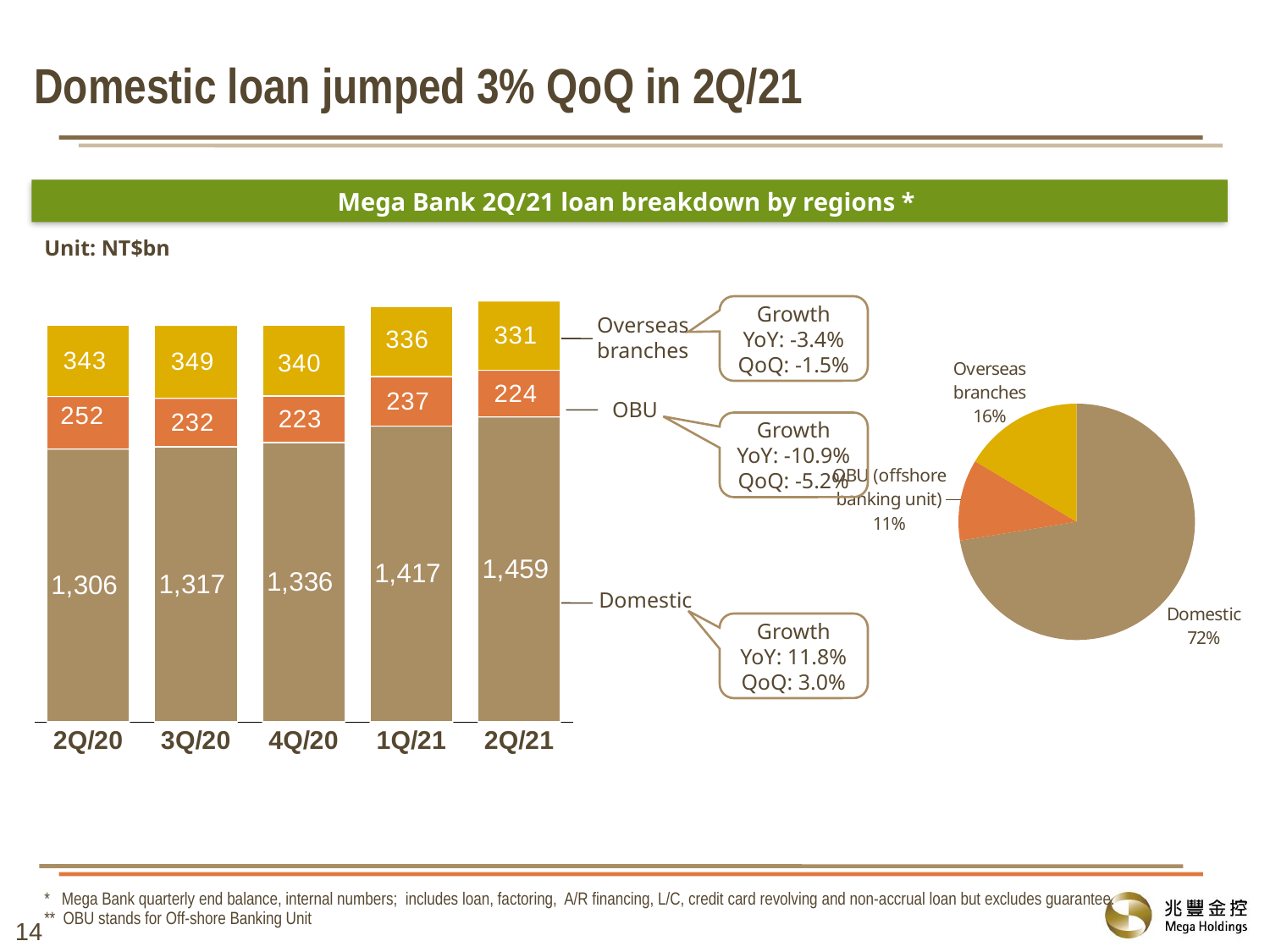
In the stacked bar chart, what is the total loan balance for 2Q/21 (sum of the three segments)? 2,014 In the stacked bar chart, what is the OBU value for 3Q/20? 232 In the stacked bar chart, what is the difference between the Domestic values for 2Q/21 and 1Q/21? 42 In the stacked bar chart, is the Overseas branches value larger in 3Q/20 or in 2Q/21? 3Q/20 In the stacked bar chart, which quarter has the lowest OBU value? 4Q/20 In the pie chart, what share of loans is Domestic? 72% In the stacked bar chart, which quarter has the highest Domestic loan value? 2Q/21 In the stacked bar chart, does the Domestic loan value rise or fall from 2Q/20 to 2Q/21? rise How many quarters are shown on the x axis of the stacked bar chart? 5 In the stacked bar chart, what is the Domestic loan value for 2Q/21? 1,459 What type of chart is shown on the right side of the slide? pie chart In the stacked bar chart, what is the Overseas branches value for 4Q/20? 340